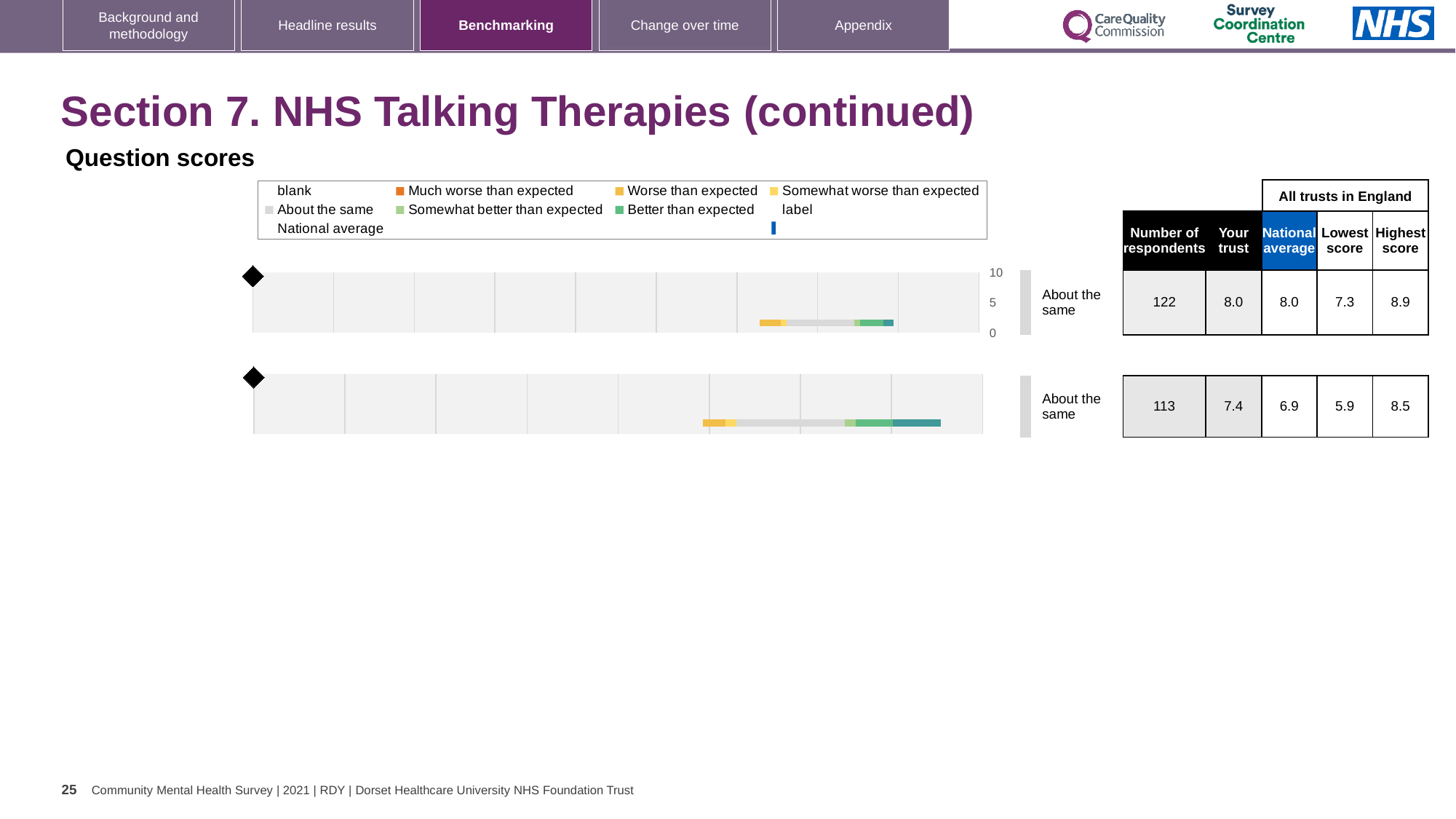
For the bottom chart, which is larger: the 'Your trust' score or the national average? Your trust What benchmark category label is shown next to both the top and bottom charts? About the same In the bottom chart's table row, what is the highest score among all trusts in England? 8.5 For the top chart, what is the difference between the highest score and the lowest score among all trusts in England? 1.6 In the top chart's table row, what is the national average score? 8.0 Which chart has more respondents, the top chart or the bottom chart? Top chart In the top chart's table row, what is the 'Your trust' score? 8.0 How many respondents are listed for the top chart? 122 In the bottom chart's table row, what is the lowest score among all trusts in England? 5.9 In the bottom chart's table row, what is the 'Your trust' score? 7.4 In the bottom chart's table row, what is the national average score? 6.9 For the bottom chart, what is the difference between the highest score and the lowest score among all trusts in England? 2.6